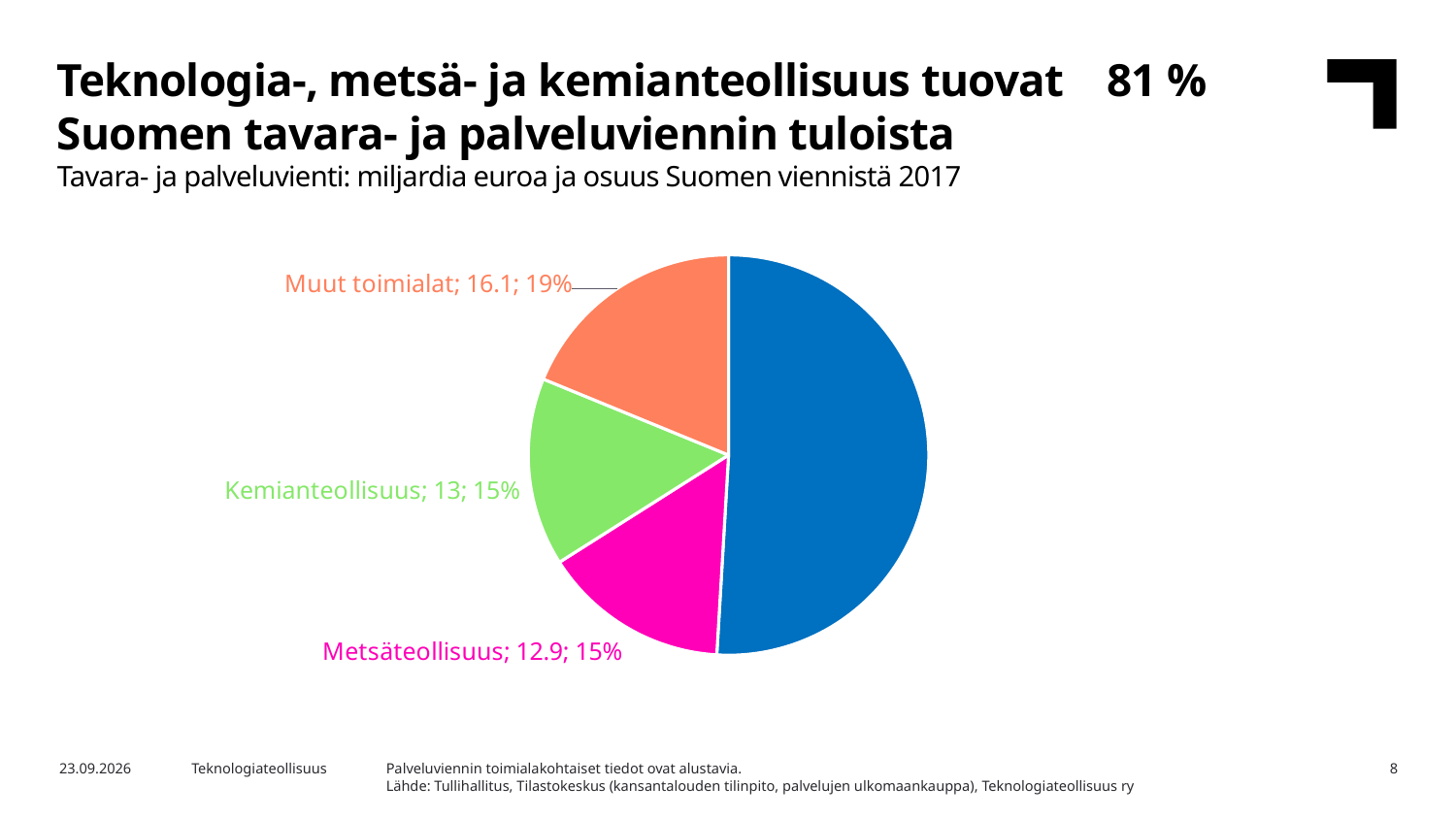
Which is larger, the value for Kemianteollisuus or the value for Metsäteollisuus? Kemianteollisuus What is the difference between the values for Muut toimialat and Metsäteollisuus? 3.2 What value in billions of euros is shown for Metsäteollisuus? 12.9 What value in billions of euros is shown for Muut toimialat? 16.1 What colour is the Metsäteollisuus slice? magenta (pink) What value in billions of euros is shown for Kemianteollisuus? 13 How many slices does the pie chart have? 4 What kind of chart is shown on the slide? pie chart What share of the pie does Muut toimialat represent? 19% What share of the pie does Metsäteollisuus represent? 15% What is the difference between the values for Muut toimialat and Kemianteollisuus? 3.1 What share of the pie does Kemianteollisuus represent? 15%